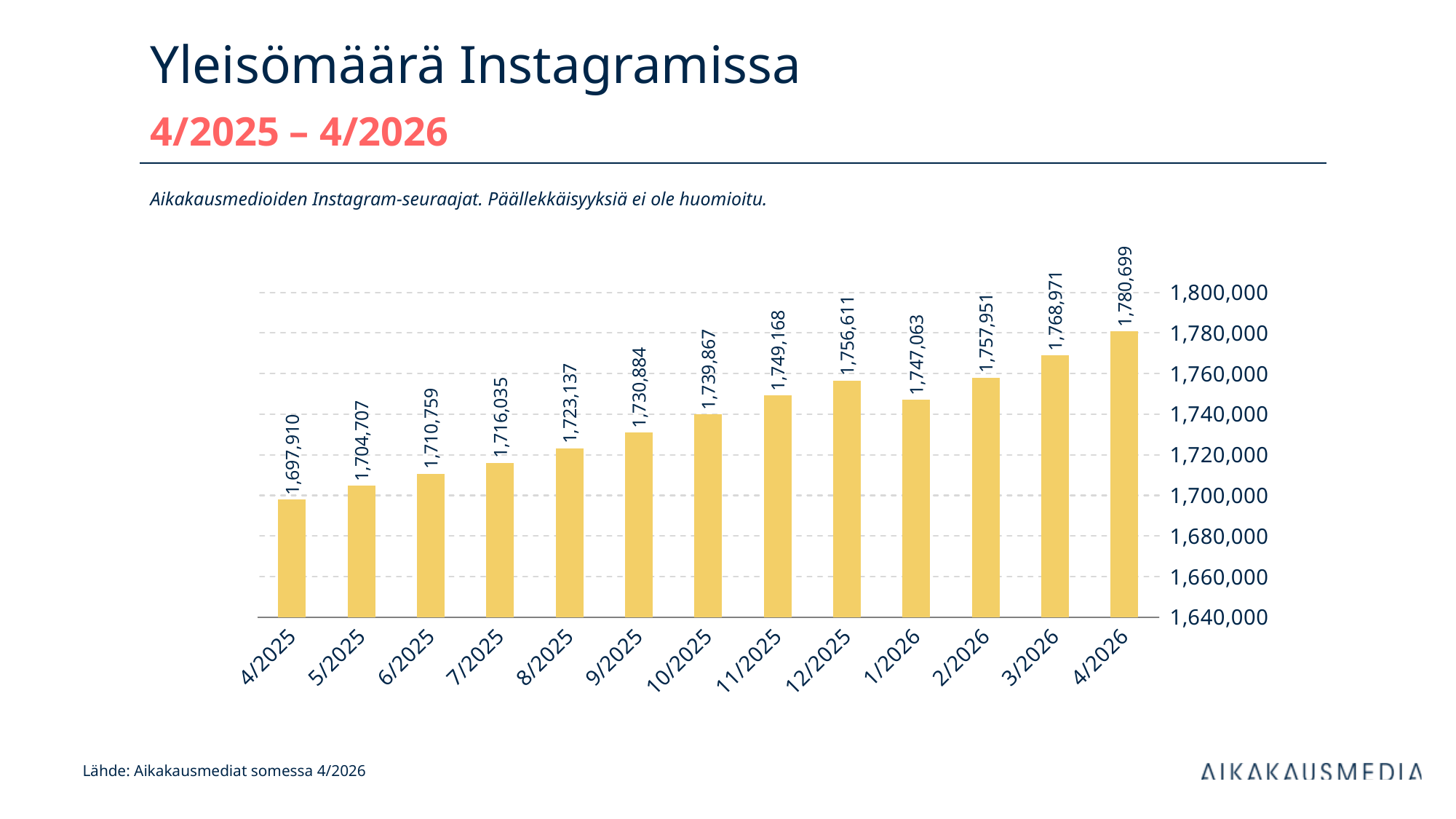
What is the value for 4/2026? 1,780,699 What is the difference between the values for 4/2026 and 4/2025? 82,789 What is the value for 1/2026? 1,747,063 What is the title of the slide? Yleisömäärä Instagramissa What is the difference between the values for 12/2025 and 1/2026? 9,548 What is the value for 4/2025? 1,697,910 What is the value for 12/2025? 1,756,611 Which is larger, the value for 12/2025 or the value for 1/2026? 12/2025 Which month has the highest value? 4/2026 What kind of chart is shown on the slide? Bar chart How many months are shown on the x axis? 13 Which month has the lowest value? 4/2025